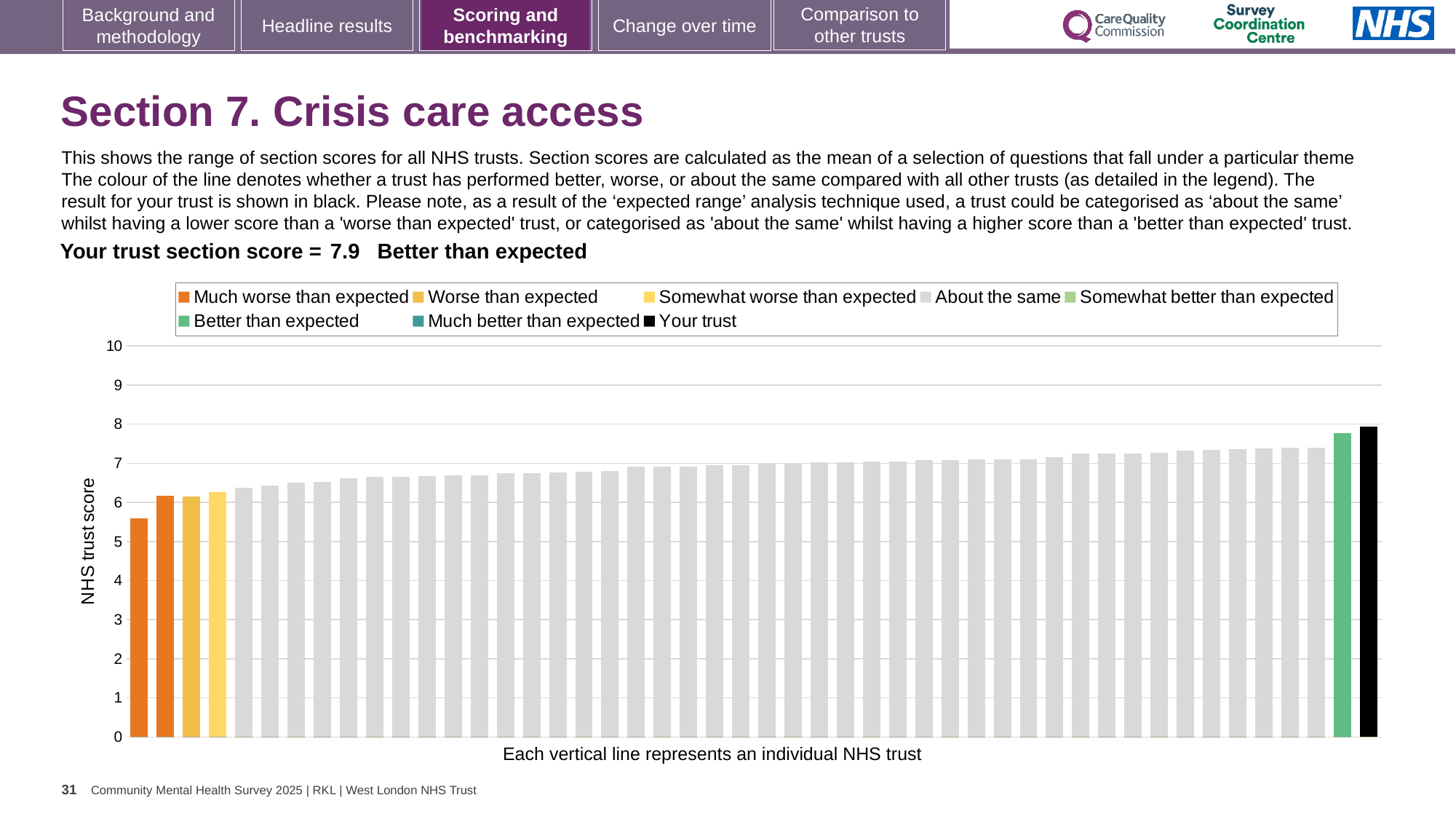
What is the section score for your trust? 7.9 Which is larger: the leftmost orange bar or the green 'Better than expected' bar? the green 'Better than expected' bar Is the value of the green 'Better than expected' bar greater or less than 7? greater Is the value of the leftmost (lowest) bar greater or less than 6? less How many bars are coloured orange (Much worse than expected)? 2 What is the label on the vertical axis? NHS trust score Do the bar values rise or fall from left to right along the x axis? rise Which bar is the lowest on the chart? the leftmost orange (Much worse than expected) bar What kind of chart is shown on the slide? bar chart How many entries does the chart legend list? 8 Is the value of the black 'Your trust' bar greater or less than 7? greater Which category is your trust placed in for this section? Better than expected